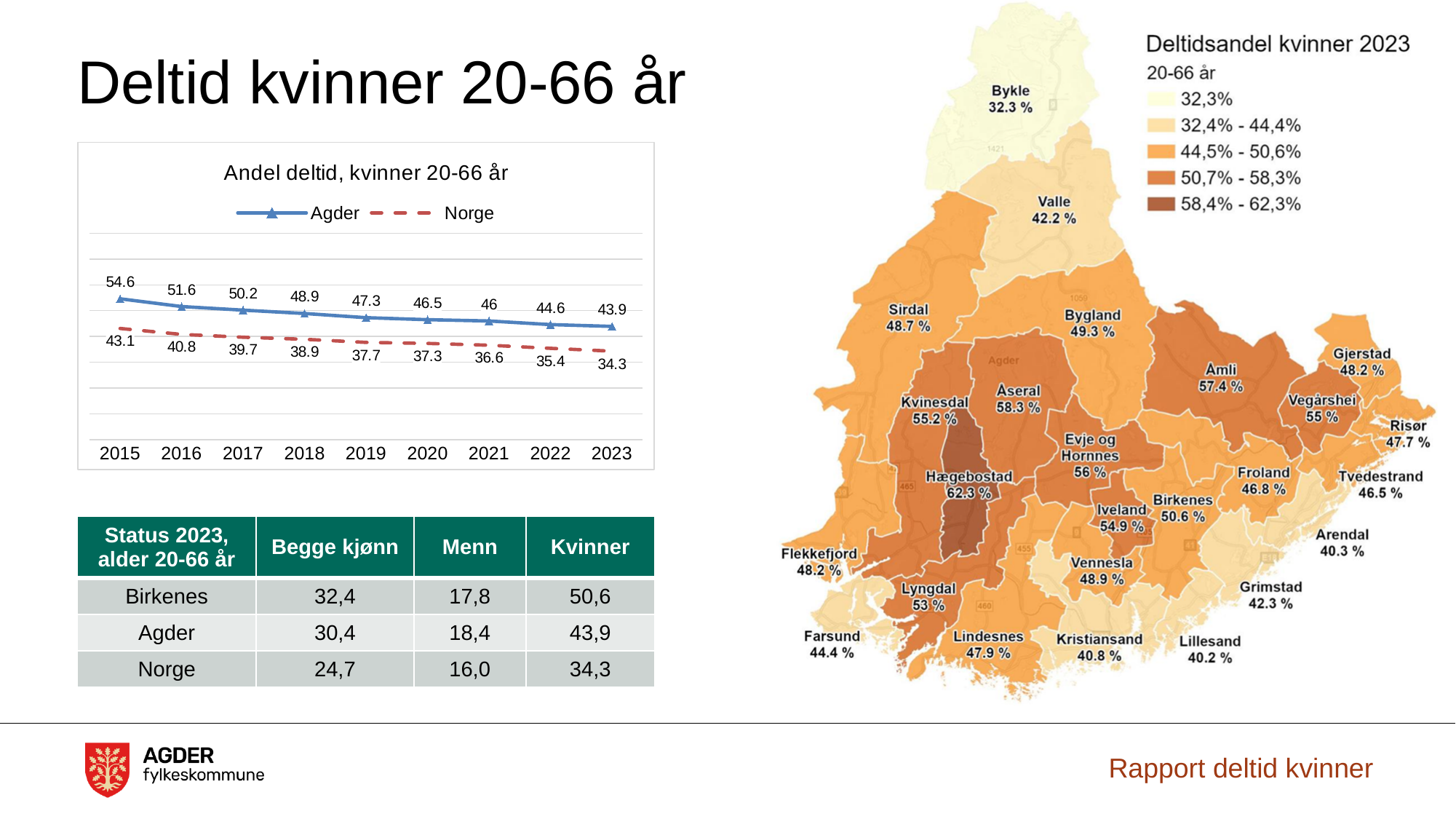
How many years are shown on the x axis of the chart 'Andel deltid, kvinner 20-66 år'? 9 Do the Norge values rise or fall from 2015 to 2023 in the chart 'Andel deltid, kvinner 20-66 år'? Fall By how much did the Agder value fall from 2015 to 2023 in the chart 'Andel deltid, kvinner 20-66 år'? 10.7 In which year is the Agder series lowest in the chart 'Andel deltid, kvinner 20-66 år'? 2023 What kind of chart is 'Andel deltid, kvinner 20-66 år'? Line chart What is the value for Norge in 2023 in the chart 'Andel deltid, kvinner 20-66 år'? 34.3 What is the value for Agder in 2015 in the chart 'Andel deltid, kvinner 20-66 år'? 54.6 In which year is the Norge series highest in the chart 'Andel deltid, kvinner 20-66 år'? 2015 What is the difference between the Agder and Norge values in 2023 in the chart 'Andel deltid, kvinner 20-66 år'? 9.6 How many series does the legend of the chart 'Andel deltid, kvinner 20-66 år' list? 2 What is the value for Agder in 2021 in the chart 'Andel deltid, kvinner 20-66 år'? 46 In 2019, which series has the larger value in the chart 'Andel deltid, kvinner 20-66 år', Agder or Norge? Agder